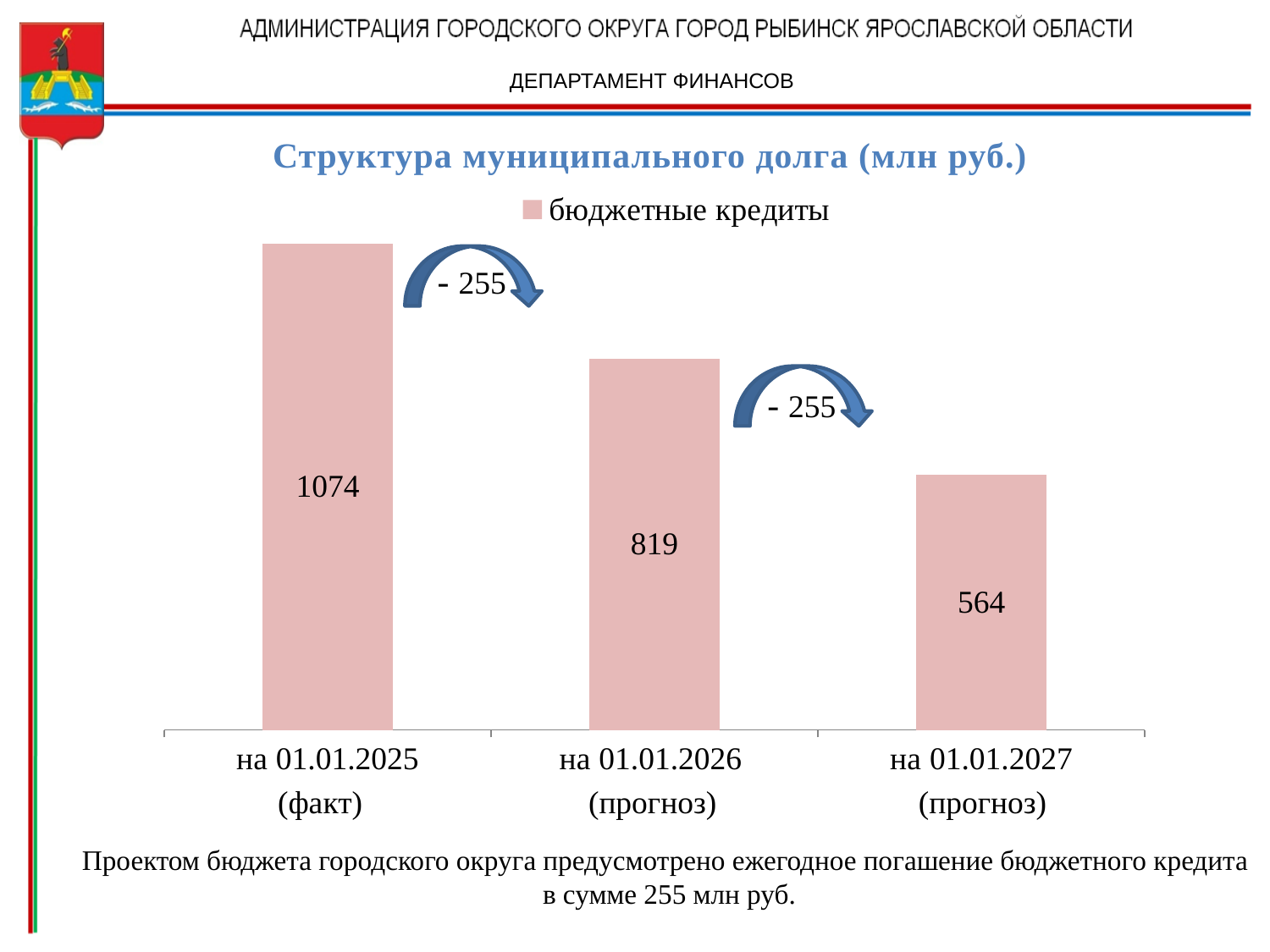
How many categories are shown on the x axis? 3 What is the value of бюджетные кредиты на 01.01.2027 (прогноз)? 564 What is the value of бюджетные кредиты на 01.01.2026 (прогноз)? 819 What is the difference between the values на 01.01.2025 and на 01.01.2026? 255 Do the values rise or fall from left to right along the x axis? fall What is the value of бюджетные кредиты на 01.01.2025 (факт)? 1074 What kind of chart is shown on the slide? bar chart Which date has the highest value of бюджетные кредиты? на 01.01.2025 (факт) How many series does the legend list? 1 What is the difference between the values на 01.01.2025 and на 01.01.2027? 510 Which is larger, the value на 01.01.2026 or на 01.01.2027? на 01.01.2026 Which date has the lowest value of бюджетные кредиты? на 01.01.2027 (прогноз)